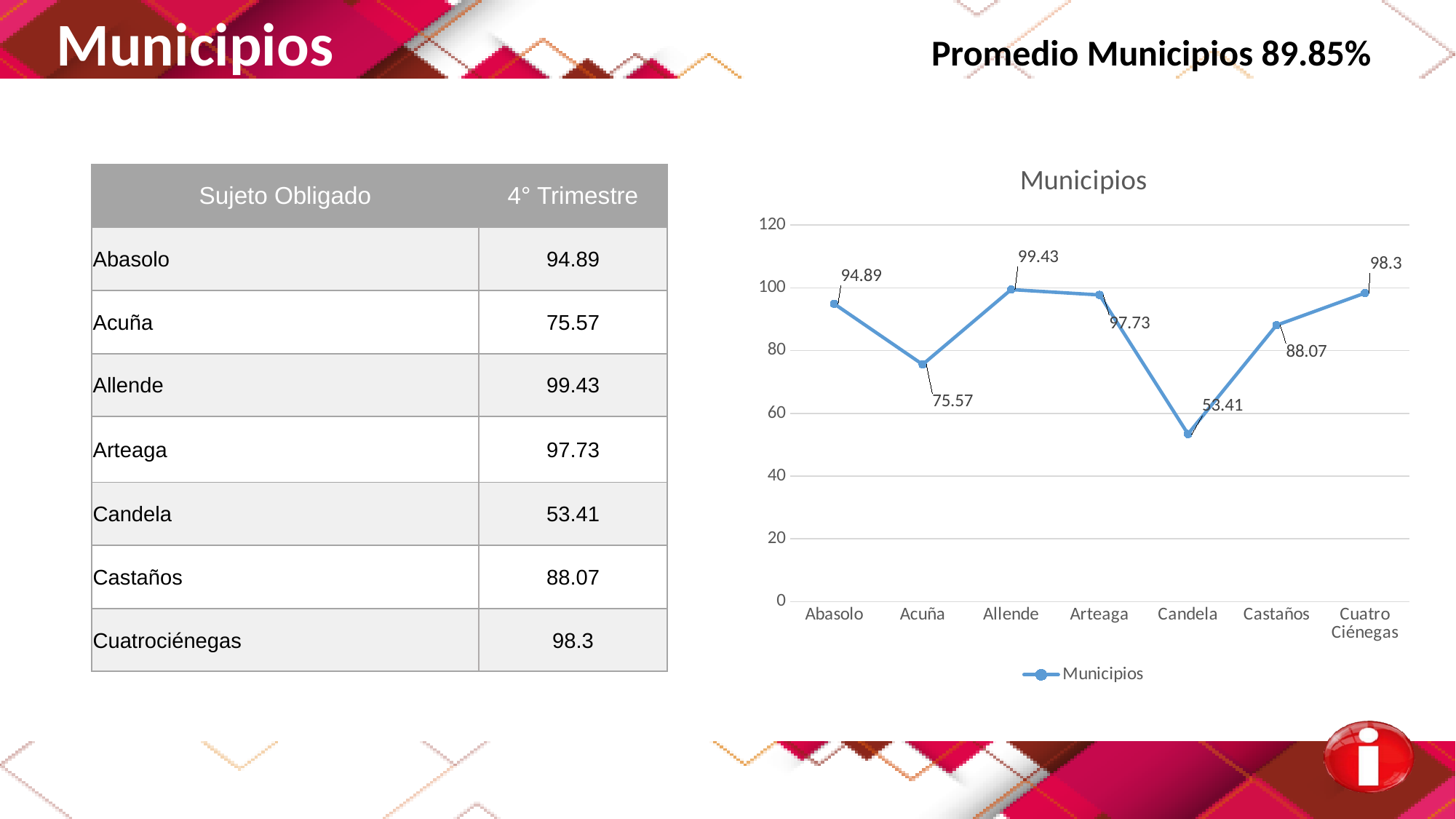
Does the value rise or fall from Candela to Castaños in the Municipios chart? rise What is the value for Candela in the Municipios chart? 53.41 How many series does the legend of the Municipios chart list? 1 Which municipality has the lowest value in the Municipios chart? Candela What is the value for Cuatro Ciénegas in the Municipios chart? 98.3 Is the value for Candela in the Municipios chart greater or less than 60? less Which municipality has the highest value in the Municipios chart? Allende What is the difference between the values for Allende and Acuña in the Municipios chart? 23.86 How many municipalities are plotted in the Municipios chart? 7 What kind of chart is the Municipios chart? line chart What is the value for Abasolo in the Municipios chart? 94.89 Which is larger in the Municipios chart, the value for Castaños or the value for Acuña? Castaños